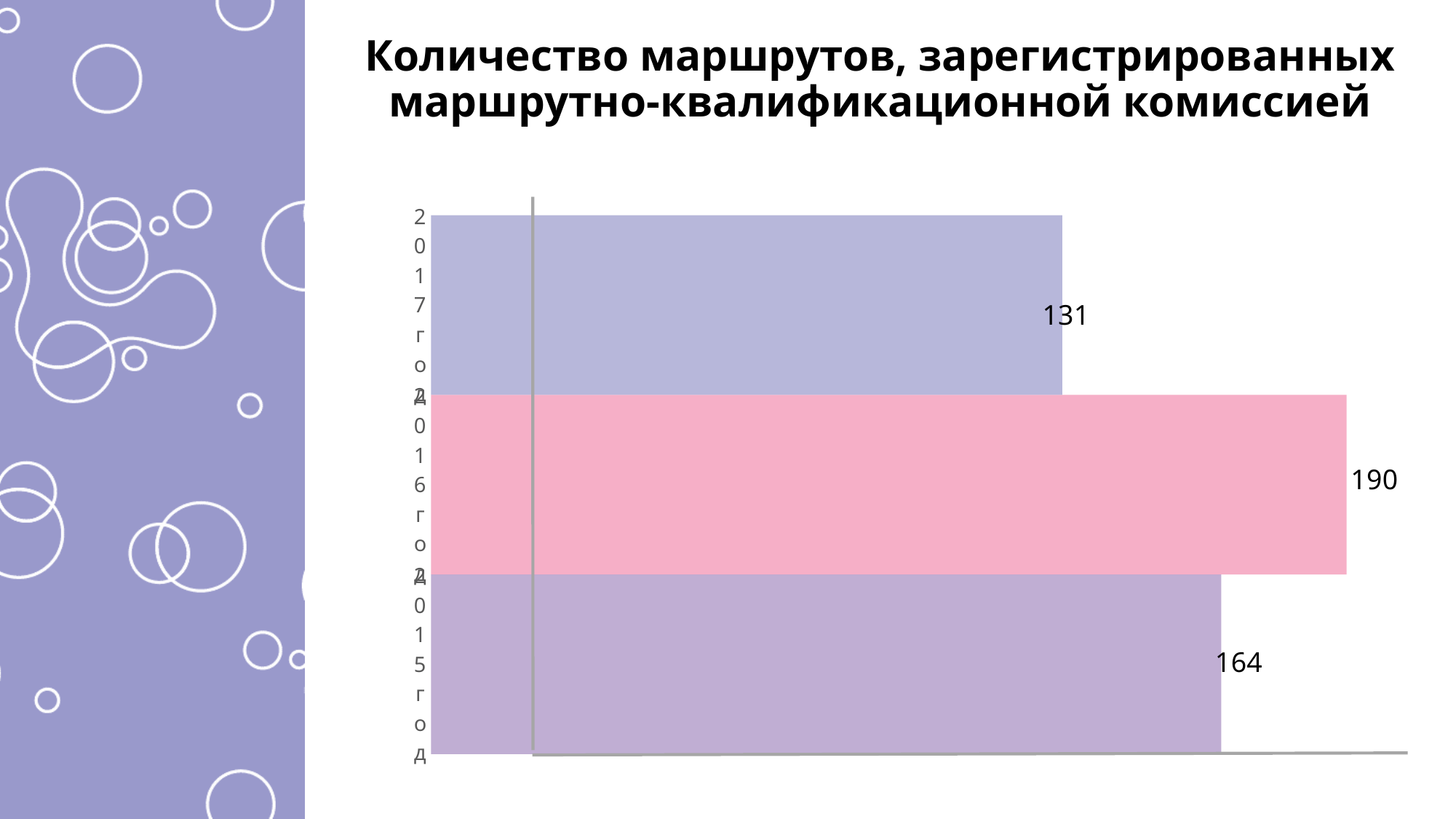
Which is larger, the value for 2015 год or the value for 2017 год? 2015 год What is the difference between the values for 2016 год and 2015 год? 26 What is the value for 2015 год? 164 What kind of chart is shown on the slide? Bar chart What is the difference between the values for 2016 год and 2017 год? 59 Which year has the highest number of routes? 2016 год What is the title of the chart? Количество маршрутов, зарегистрированных маршрутно-квалификационной комиссией What is the value for 2016 год? 190 What is the value for 2017 год? 131 How many bars are shown in the chart? 3 Which year has the lowest number of routes? 2017 год What is the difference between the values for 2015 год and 2017 год? 33